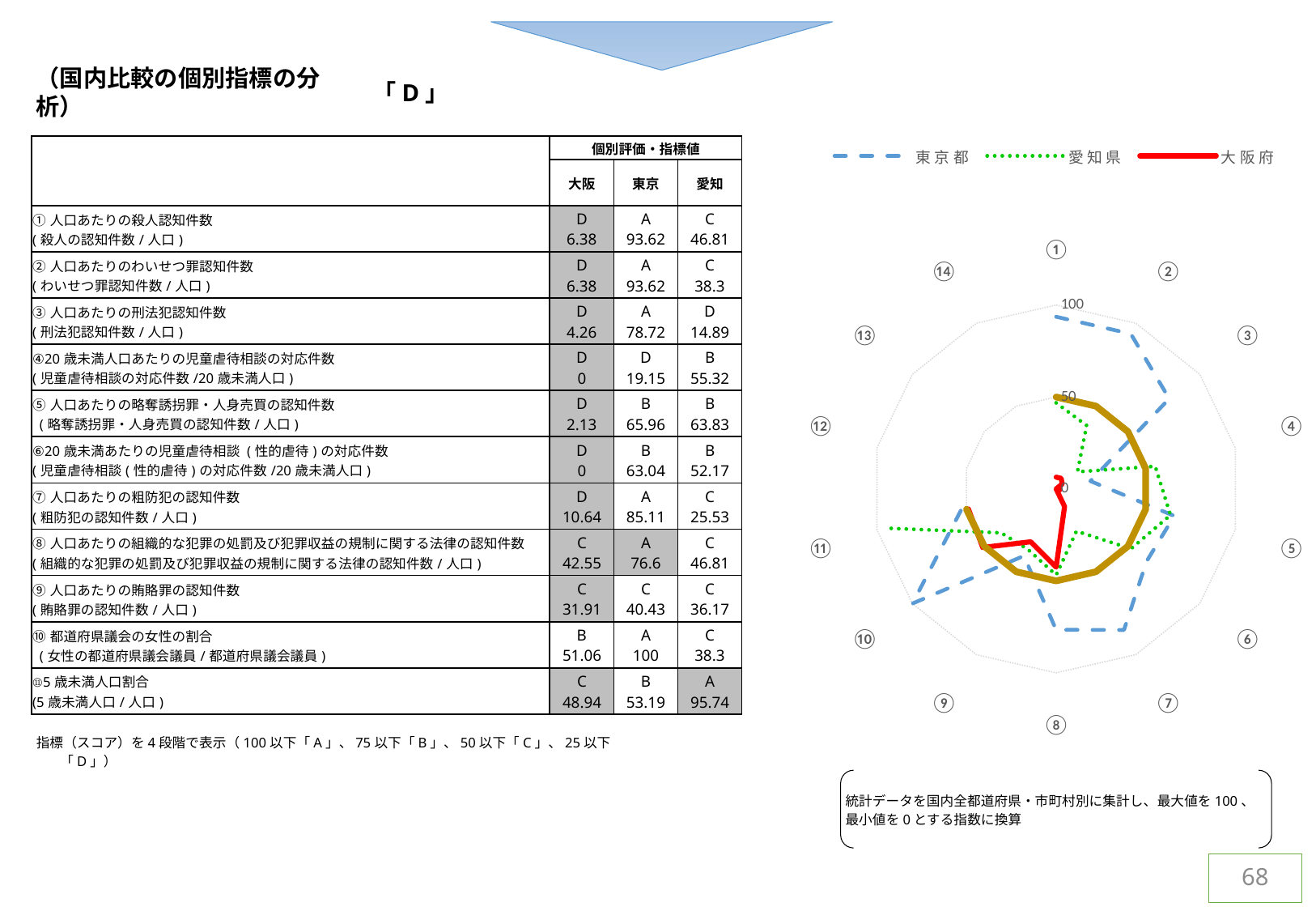
What is the highest value shown on the radar chart's axis scale? 100 What kind of chart is shown on the right side of the slide? radar chart How many numbered categories (axes) does the radar chart have? 14 Which series in the radar chart is drawn as a solid red line? 大阪府 In the radar chart, is the value for 愛知県 at category ⑪ greater or less than 50? greater How many series does the legend of the radar chart list? 3 In the radar chart, which series has the larger value at category ⑧, 東京都 or 大阪府? 東京都 Which series in the radar chart is drawn as a dashed blue line? 東京都 In the radar chart, is the value for 東京都 at category ⑧ greater or less than 50? greater In the radar chart, is the value for 大阪府 at category ① greater or less than 50? less In the radar chart, which series has the larger value at category ⑪, 愛知県 or 大阪府? 愛知県